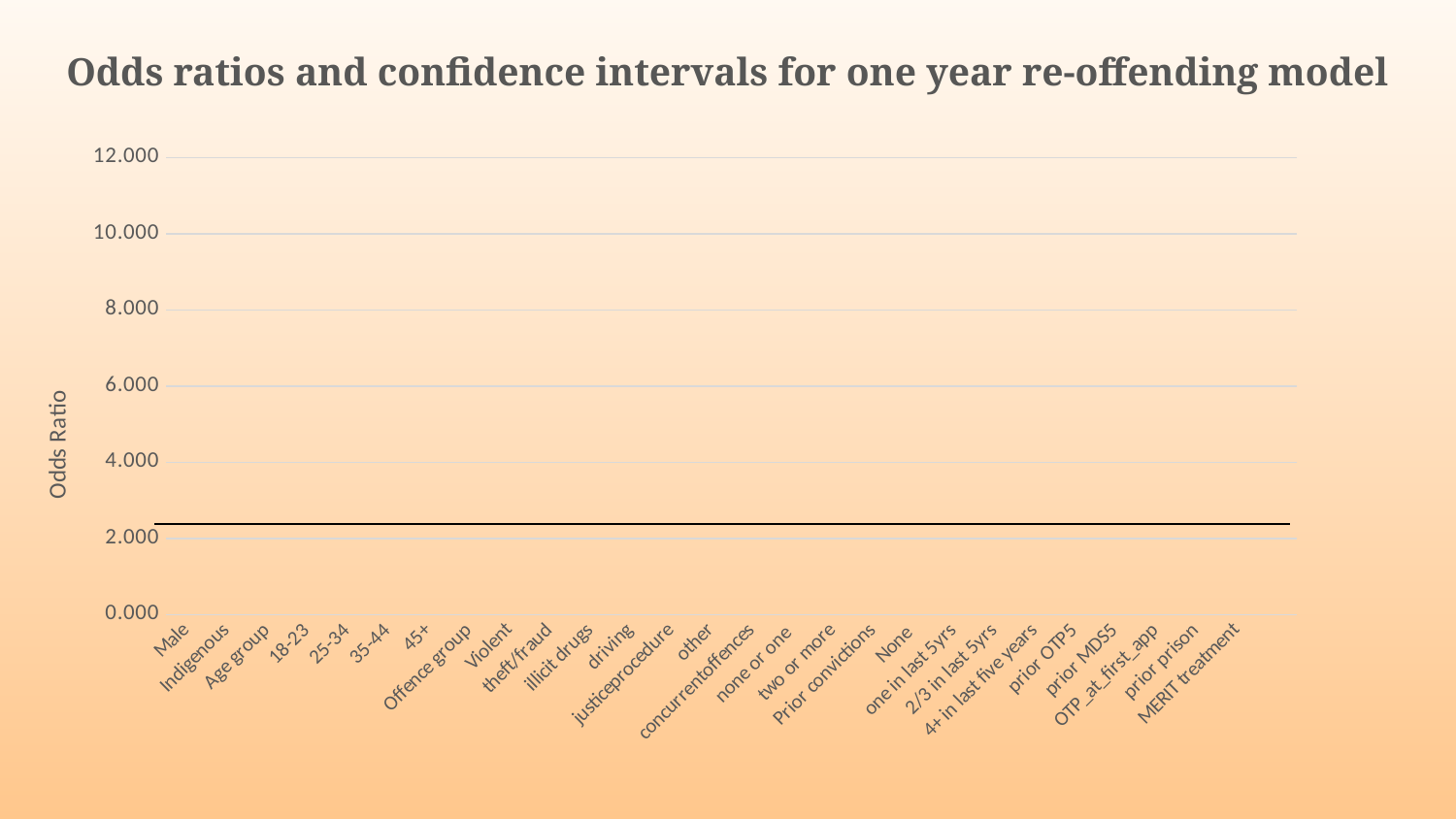
What is the title of the chart? Odds ratios and confidence intervals for one year re-offending model How many categories are listed along the x axis of the chart? 27 Is the value for Violent greater or less than 2.000? greater Is the value for prior prison greater or less than 6.000? less Is the value for Indigenous greater or less than 8.000? less Do the plotted values rise, fall, or stay flat from Male to MERIT treatment along the x axis? stay flat What is the highest value shown on the vertical axis of the chart? 12.000 What is the label on the vertical axis of the chart? Odds Ratio What kind of chart is shown on the slide? line chart